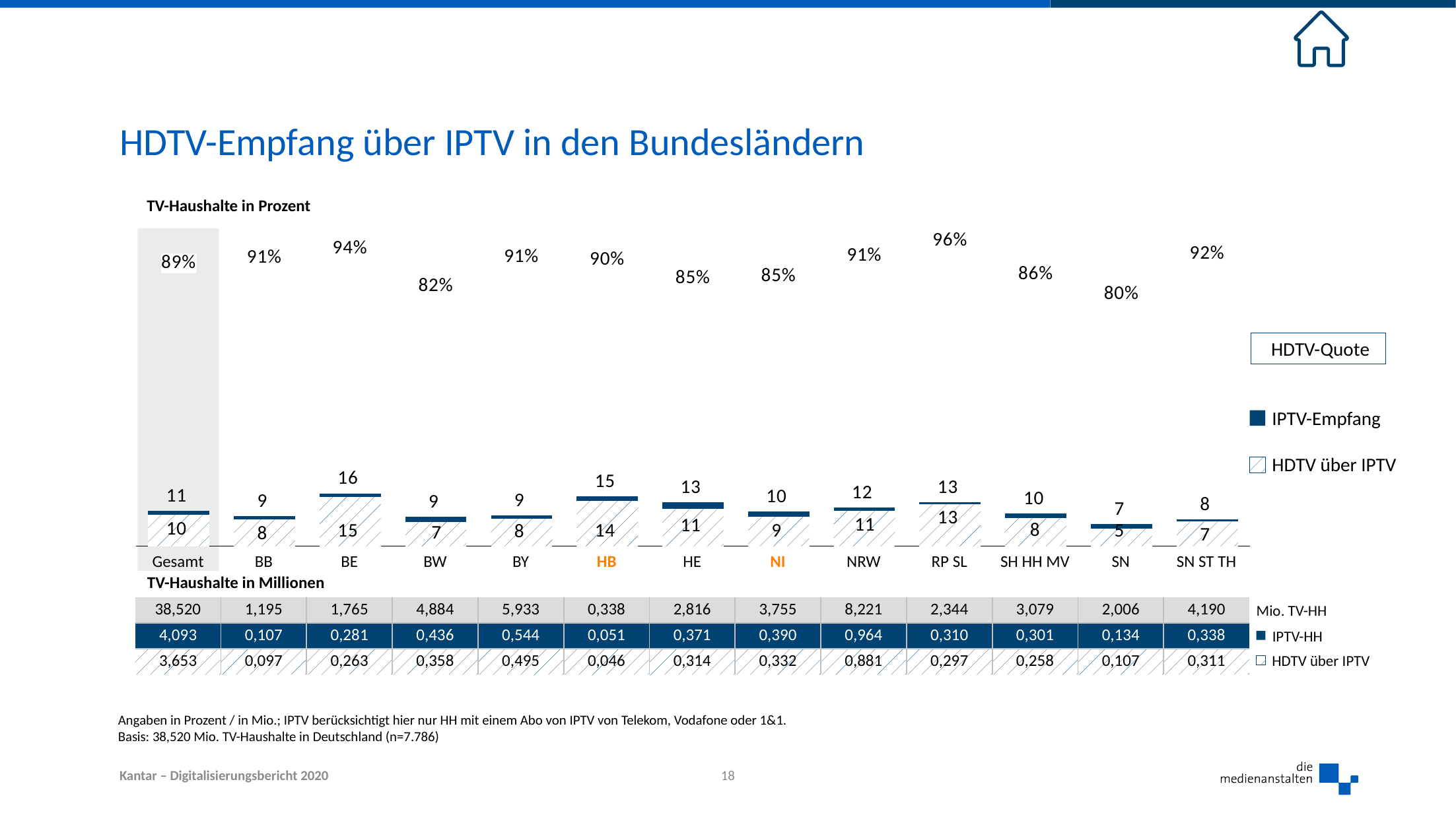
Which category has the lowest HDTV-Quote? SN What is the HDTV über IPTV value for HB? 14 What kind of chart is used to show IPTV-Empfang and HDTV über IPTV? bar chart In the table below the chart, how many Mio. TV-HH are listed for NRW? 8,221 Which category has the highest HDTV-Quote? RP SL How many categories are shown along the x axis of the chart? 13 What is the HDTV-Quote shown for BW? 82% What is the difference between the IPTV-Empfang values for BE and SN? 9 What is the IPTV-Empfang value (in percent of TV households) for BE? 16 In the table below the chart, what is the IPTV-HH value for Gesamt? 4,093 Which Bundesland has the highest IPTV-Empfang value? BE Is the IPTV-Empfang value larger for HB or for HE? HB